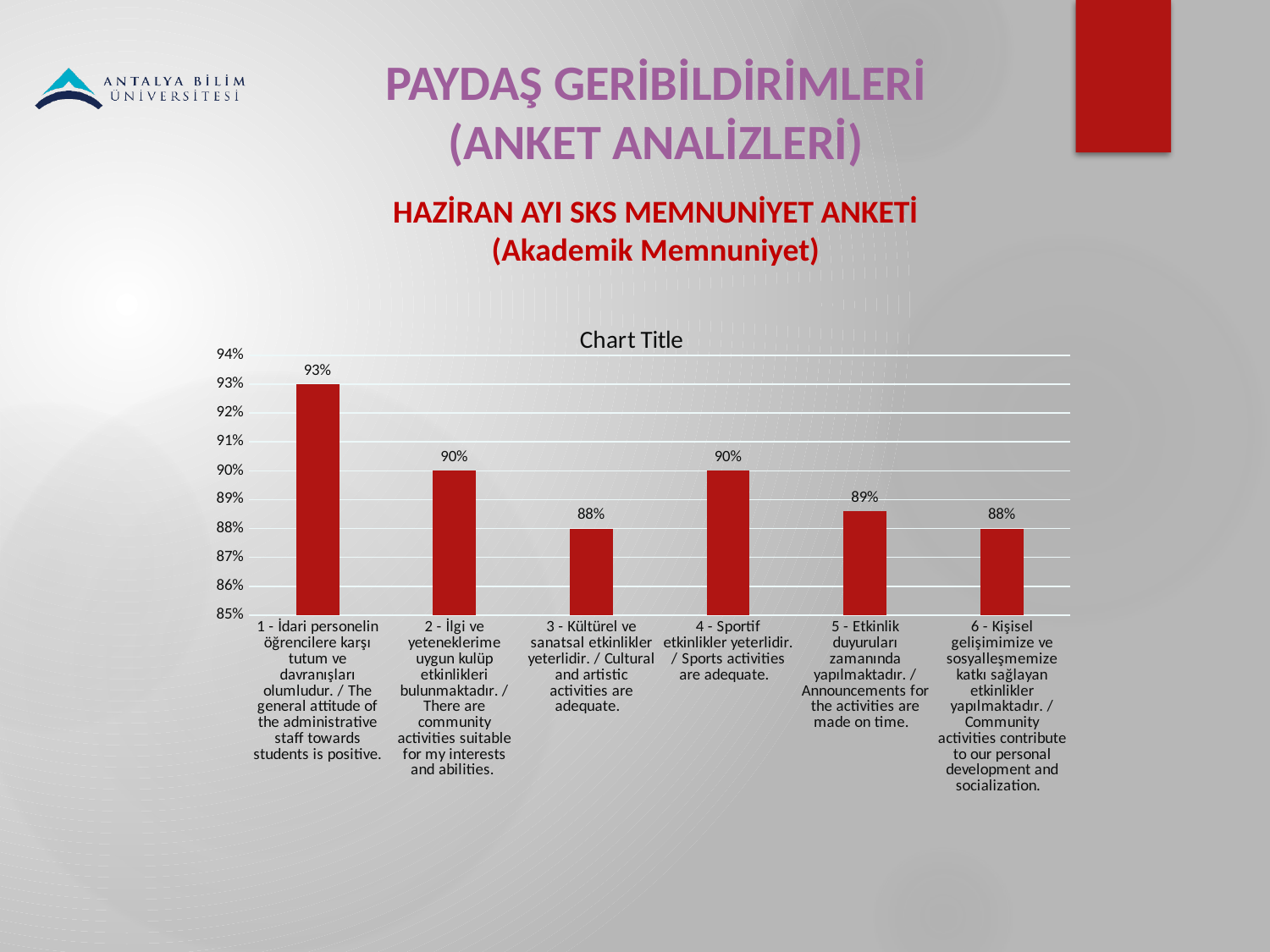
What is the difference between the value for category 1 and the value for category 6? 5% What is the value for category 5 (Etkinlik duyuruları zamanında yapılmaktadır)? 89% Is the value for category 4 (Sportif etkinlikler yeterlidir) greater or less than 89%? greater Which is larger, the value for category 2 (İlgi ve yeteneklerime uygun kulüp etkinlikleri bulunmaktadır) or the value for category 5 (Etkinlik duyuruları zamanında yapılmaktadır)? Category 2 What is the highest value shown on the vertical axis? 94% What is the title printed above the chart? Chart Title What kind of chart is shown on the slide? Bar chart What is the difference between the value for category 2 and the value for category 3? 2% How many categories are shown in the chart? 6 What is the value for category 3 (Kültürel ve sanatsal etkinlikler yeterlidir)? 88% Which category has the highest value? 1 - İdari personelin öğrencilere karşı tutum ve davranışları olumludur What is the value for category 1 (İdari personelin öğrencilere karşı tutum ve davranışları olumludur)? 93%